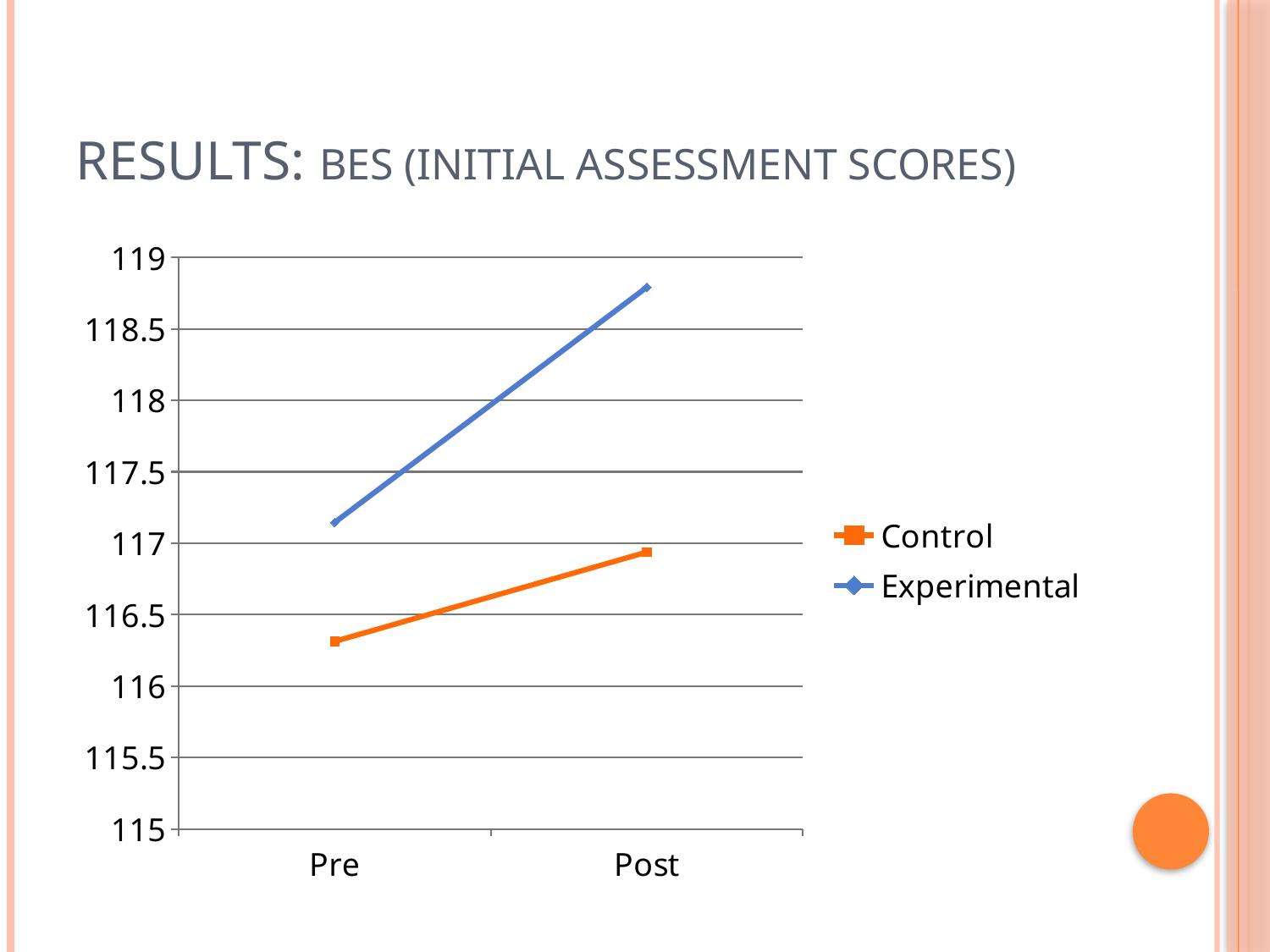
Is the Control value at Post greater or less than 117? less Does the Control series rise or fall from Pre to Post? rise How many series does the legend list? 2 What kind of chart is shown on the slide? line chart Is the Experimental value at Pre greater or less than 117? greater Is the Experimental value at Post greater or less than 118.5? greater Which series has the higher value at Pre? Experimental Does the Experimental series rise or fall from Pre to Post? rise Which series is drawn in orange? Control Which series has the higher value at Post? Experimental How many points are on the x axis? 2